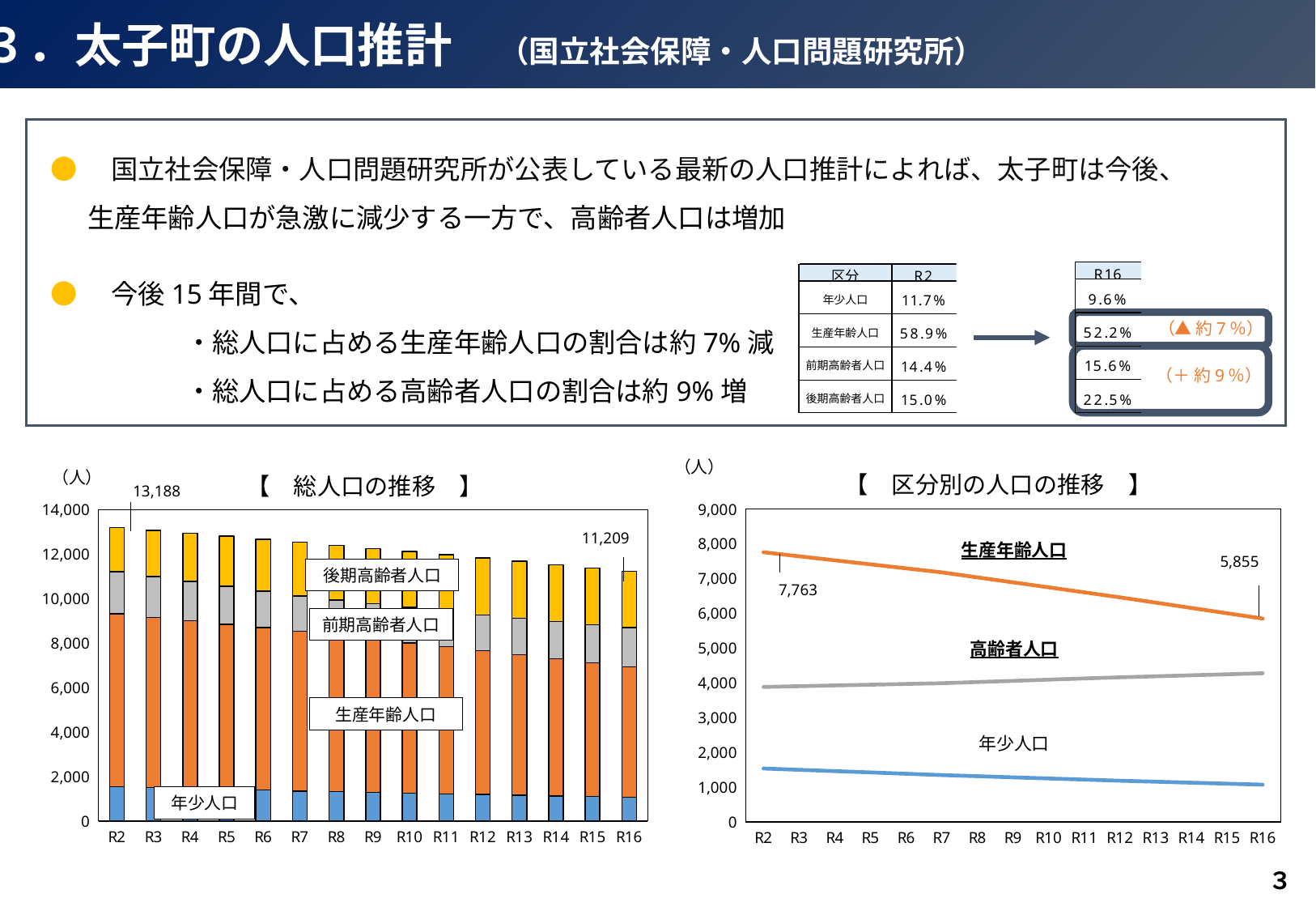
In the 区分別の人口の推移 chart, what is the value of 生産年齢人口 for R16? 5,855 In the 区分別の人口の推移 chart, which series has the lowest values across all years? 年少人口 What kind of chart is the 区分別の人口の推移 chart on the right? line chart In the 総人口の推移 chart, what is the total population for R2? 13,188 In the 総人口の推移 chart, what is the total population for R16? 11,209 In the 総人口の推移 chart, does the total population rise or fall from R2 to R16? fall In the 総人口の推移 chart, how many years are shown on the x axis? 15 What kind of chart is the 総人口の推移 chart on the left? stacked bar chart In the 区分別の人口の推移 chart, is the value of 高齢者人口 for R16 greater or less than 4,000? greater In the 総人口の推移 chart, is the total for R16 greater or less than 12,000? less In the 総人口の推移 chart, what is the difference between the R2 total and the R16 total? 1,979 In the 区分別の人口の推移 chart, what is the value of 生産年齢人口 for R2? 7,763